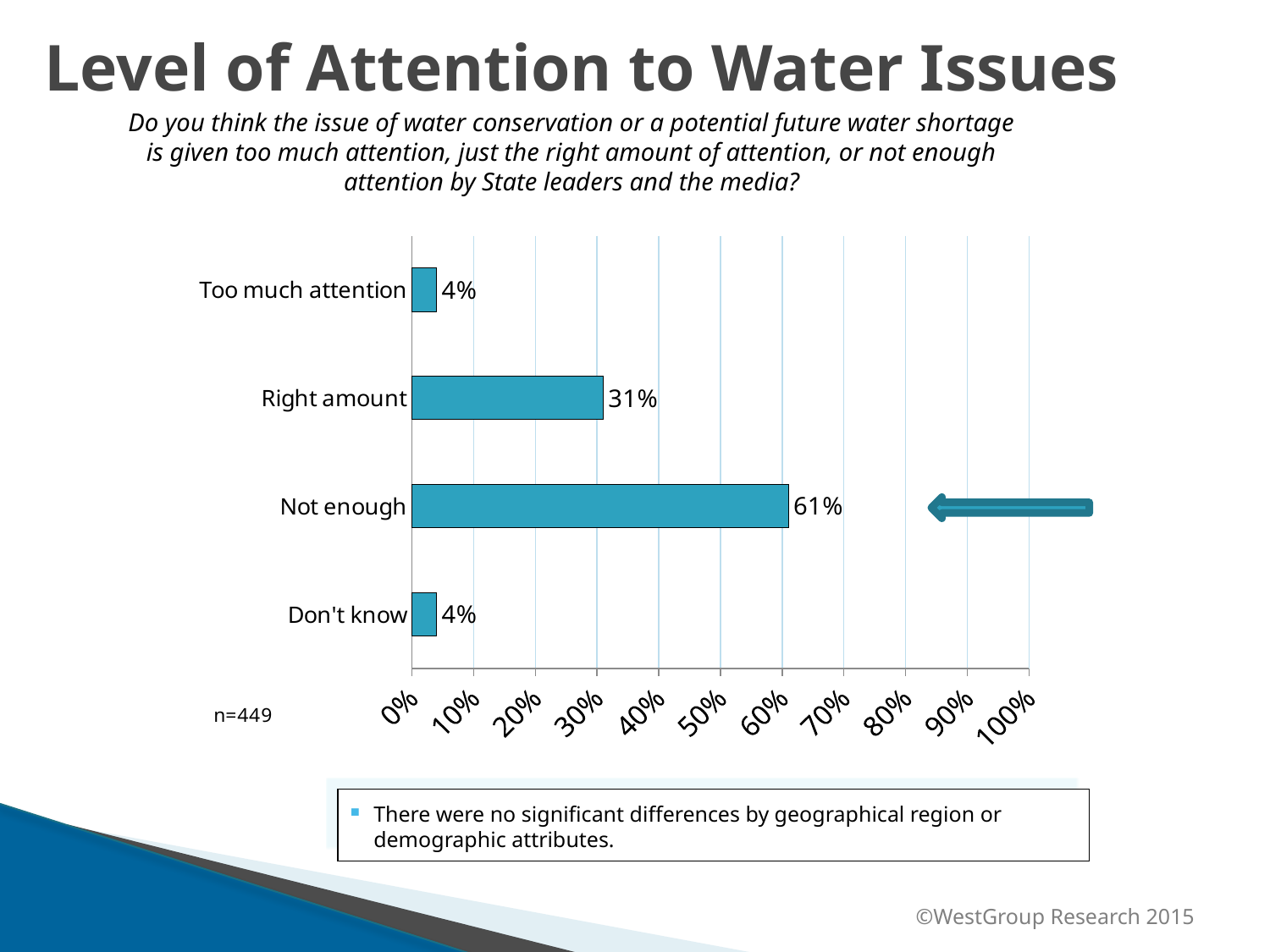
Which is larger, the value for "Right amount" or the value for "Too much attention"? Right amount What kind of chart is shown on the slide? Bar chart What is the highest value shown on the x axis of the chart? 100% Which response category has the highest percentage? Not enough What percentage of respondents said water issues receive "Not enough" attention? 61% Is the value for "Not enough" greater or less than 50%? greater How many response categories are shown in the chart? 4 What percentage of respondents said water issues receive the "Right amount" of attention? 31% What percentage of respondents answered "Don't know"? 4% What is the difference in percentage points between "Not enough" and "Right amount"? 30 What percentage of respondents said water issues receive "Too much attention"? 4% What is the sample size (n) shown on the slide? 449